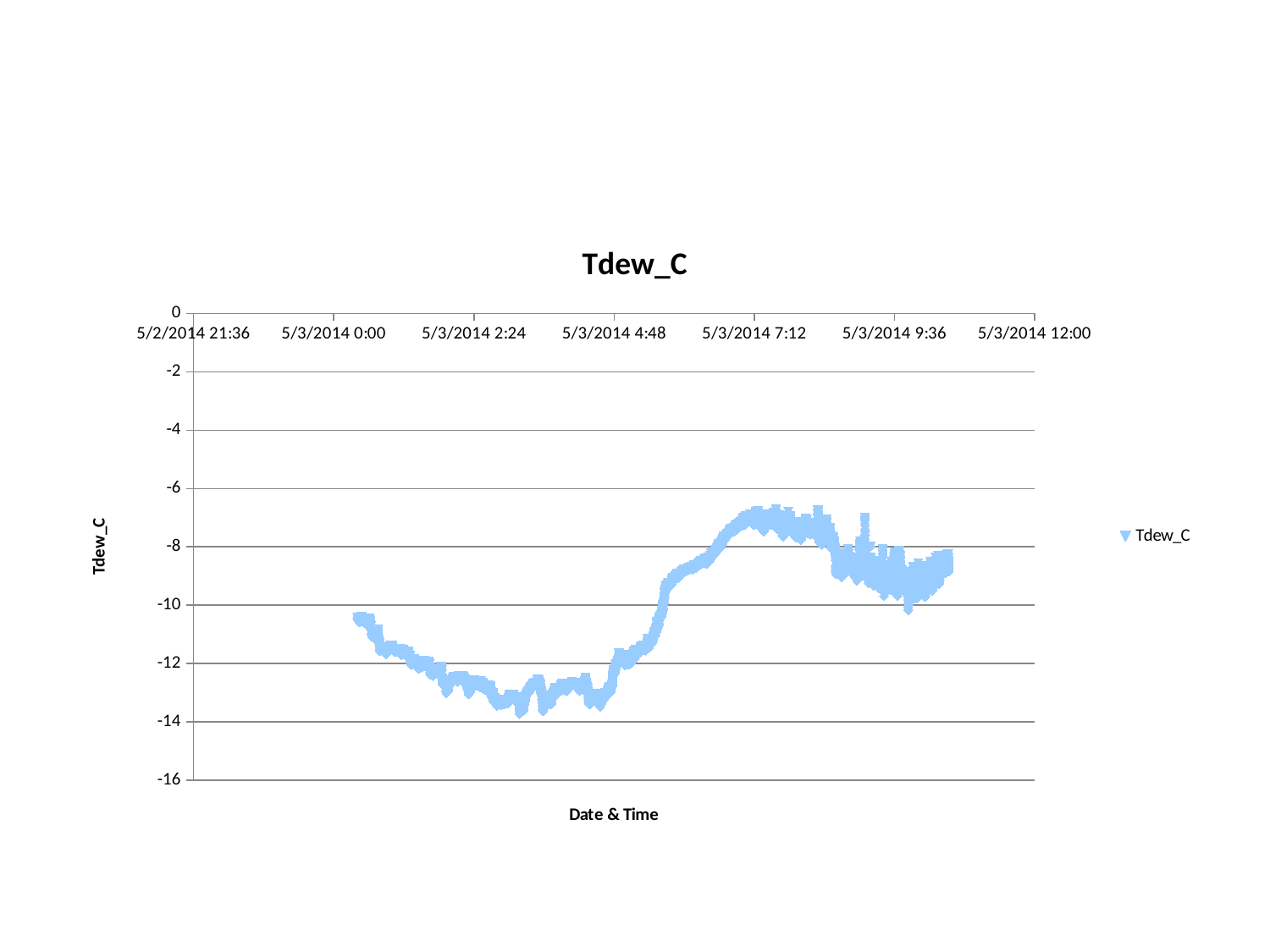
What is the label of the horizontal axis? Date & Time Do the Tdew_C values rise or fall between 5/3/2014 2:24 and 5/3/2014 7:12? rise Do the Tdew_C values rise or fall between 5/3/2014 7:12 and 5/3/2014 9:36? fall What is the title of the chart? Tdew_C What kind of chart is shown on the slide? scatter chart Is the Tdew_C value at 5/3/2014 0:00 greater or less than -10? less Is the Tdew_C value higher at 5/3/2014 0:00 or at 5/3/2014 2:24? 5/3/2014 0:00 Is the Tdew_C value higher at 5/3/2014 7:12 or at 5/3/2014 2:24? 5/3/2014 7:12 Is the Tdew_C value at 5/3/2014 7:12 greater or less than -8? greater Is the Tdew_C value at 5/3/2014 9:36 greater or less than -10? greater How many series does the legend list? 1